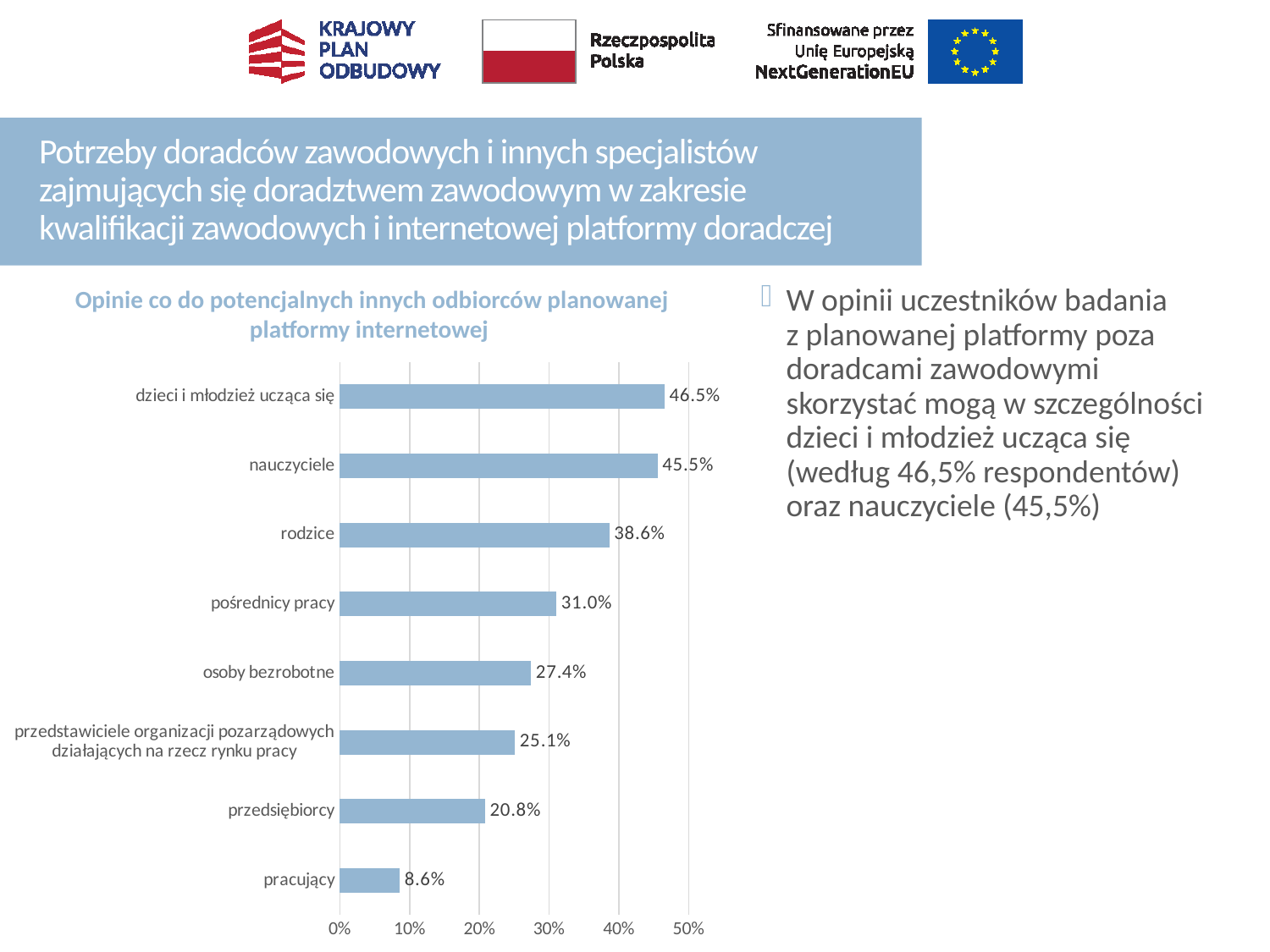
Which category has the lowest value? pracujący What is the value for "pracujący"? 8.6% What is the value for "nauczyciele"? 45.5% What kind of chart is shown on the slide? bar chart What is the difference between the values for "dzieci i młodzież ucząca się" and "nauczyciele"? 1.0% What is the value for "przedstawiciele organizacji pozarządowych działających na rzecz rynku pracy"? 25.1% What is the difference between the values for "pośrednicy pracy" and "osoby bezrobotne"? 3.6% Which category has the highest value? dzieci i młodzież ucząca się How many categories are shown in the chart? 8 What is the value for "rodzice"? 38.6% What is the title of the chart? Opinie co do potencjalnych innych odbiorców planowanej platformy internetowej Which is larger, the value for "przedsiębiorcy" or the value for "osoby bezrobotne"? osoby bezrobotne